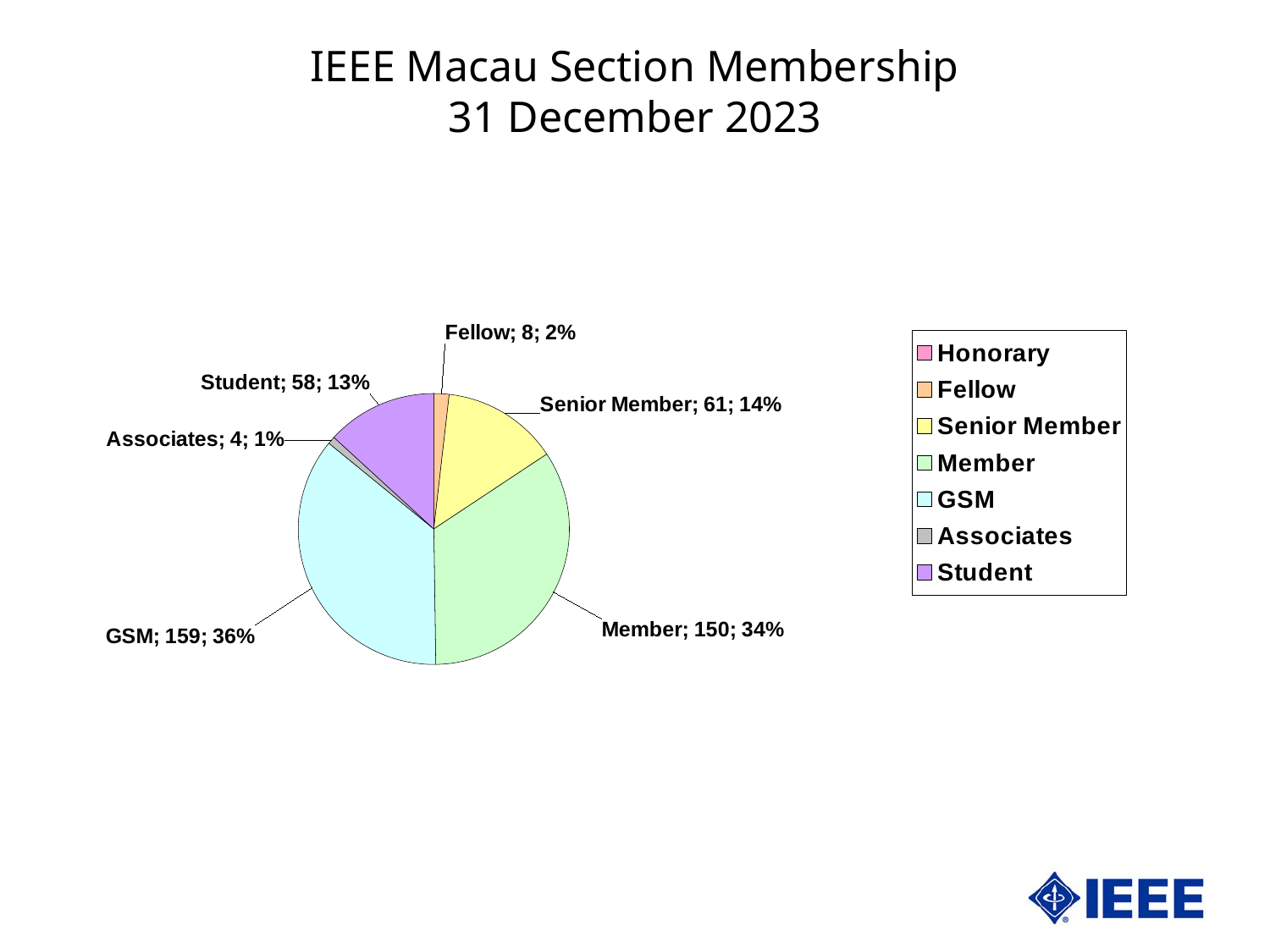
Which is larger, the Senior Member count or the Student count? Senior Member Which category has the largest slice of the pie? GSM What colour is the Member slice in the pie chart? light green How many Fellows are shown in the pie chart? 8 How many entries does the legend list? 7 What percentage of the membership is Senior Member? 14% What is the difference in count between GSM and Member? 9 What share of the pie does the Student slice represent? 13% What is the title of the slide containing the pie chart? IEEE Macau Section Membership 31 December 2023 How many members are in the GSM category? 159 Which labelled category has the smallest slice of the pie? Associates What type of chart is shown on the slide? pie chart